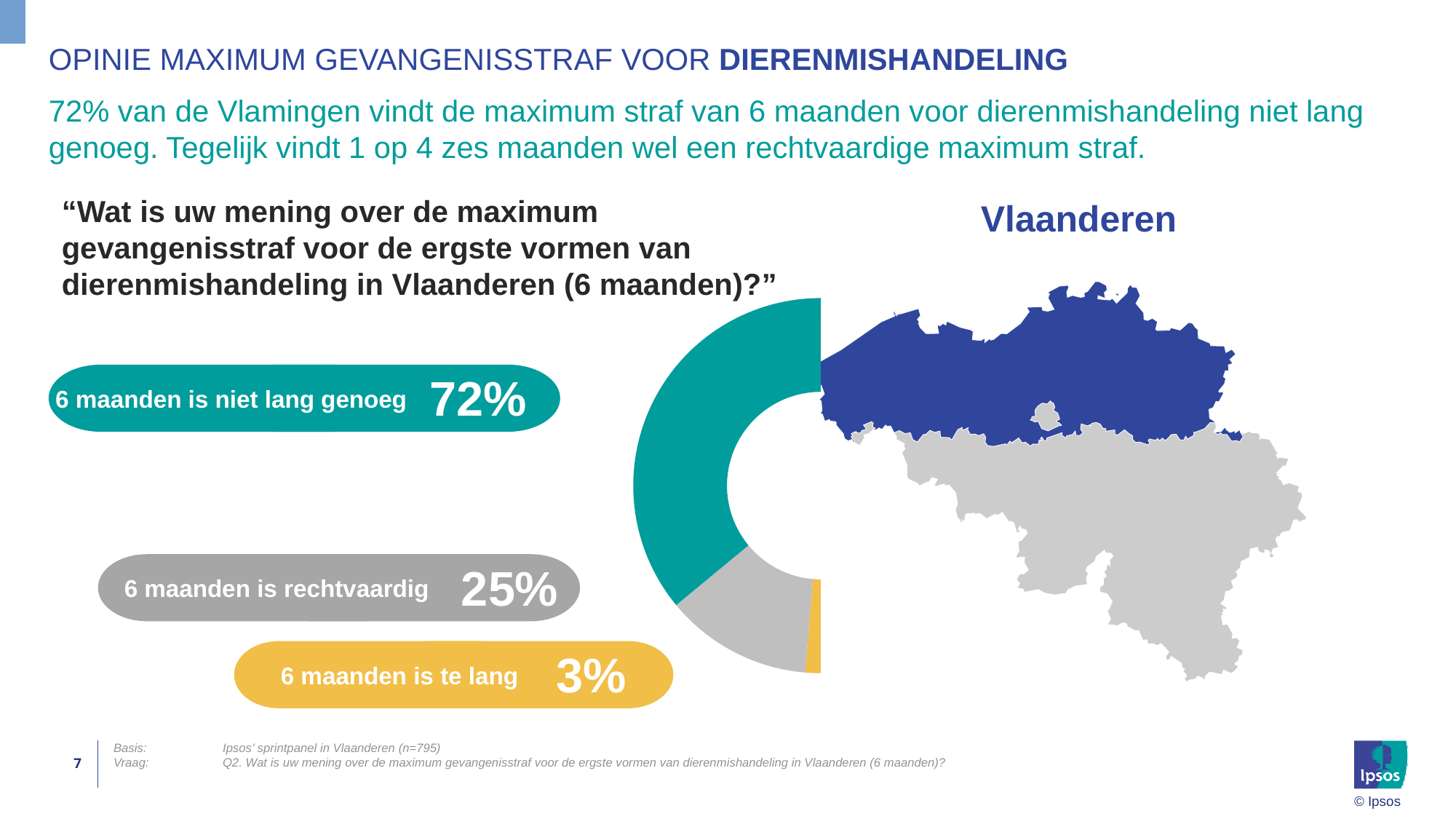
What kind of chart is used to show the responses? Donut chart Which response has the smallest share in the chart? 6 maanden is te lang Which response has the largest share in the chart? 6 maanden is niet lang genoeg How many percentage points higher is '6 maanden is niet lang genoeg' than '6 maanden is rechtvaardig'? 47 percentage points What percentage of respondents say '6 maanden is te lang'? 3% How many response categories are shown in the chart? 3 What percentage of respondents say '6 maanden is rechtvaardig'? 25% What percentage of respondents say '6 maanden is niet lang genoeg'? 72% What is the difference in percentage points between '6 maanden is rechtvaardig' and '6 maanden is te lang'? 22 percentage points What share of the chart does the '6 maanden is niet lang genoeg' segment represent? 72% What colour is the segment for '6 maanden is te lang'? Yellow Which is larger: the share for '6 maanden is rechtvaardig' or for '6 maanden is te lang'? 6 maanden is rechtvaardig